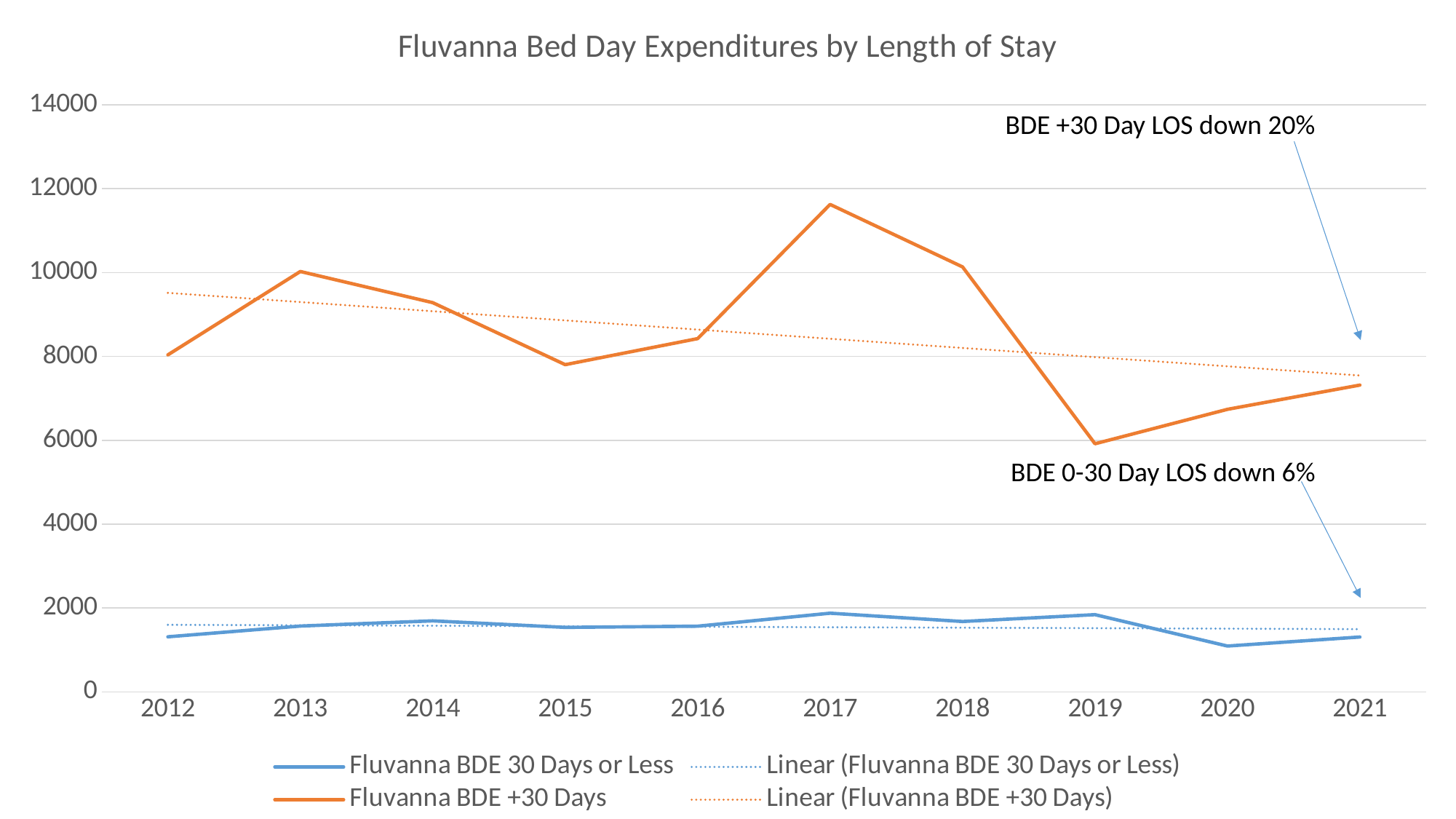
How many entries does the legend list? 4 Is the value for Fluvanna BDE +30 Days in 2019 greater or less than 8000? less Is the value for Fluvanna BDE +30 Days in 2017 greater or less than 10000? greater Which year has the larger value for Fluvanna BDE +30 Days, 2013 or 2015? 2013 What kind of chart is shown on the slide? line chart In which year does the Fluvanna BDE +30 Days series reach its highest value? 2017 In which year does the Fluvanna BDE +30 Days series reach its lowest value? 2019 What is the title of the chart? Fluvanna Bed Day Expenditures by Length of Stay According to the annotation on the chart, by what percentage is BDE +30 Day LOS down? 20% Is the value for Fluvanna BDE 30 Days or Less in 2017 greater or less than 2000? less In which year does the Fluvanna BDE 30 Days or Less series reach its lowest value? 2020 How many years are plotted along the x axis? 10